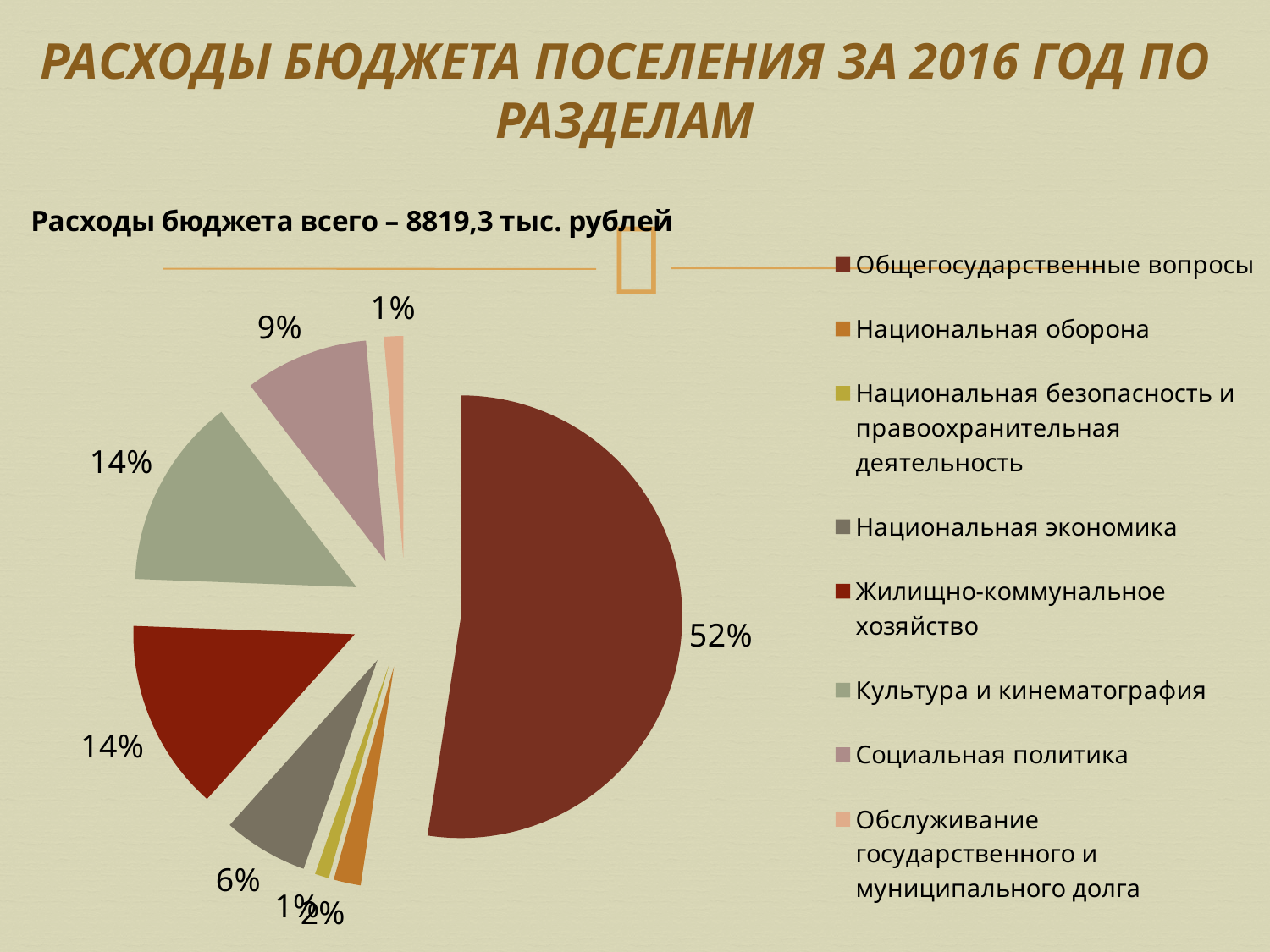
What share of the budget expenditure goes to Национальная экономика? 6% By how many percentage points does the share of Общегосударственные вопросы exceed the share of Социальная политика? 43 percentage points What share of the budget expenditure goes to Общегосударственные вопросы? 52% What kind of chart is shown on the slide? pie chart What share of the budget expenditure goes to Культура и кинематография? 14% Which section has the largest share of the budget expenditure? Общегосударственные вопросы How many sections (slices) does the pie chart show? 8 What share of the budget expenditure goes to Обслуживание государственного и муниципального долга? 1% What share of the budget expenditure goes to Жилищно-коммунальное хозяйство? 14% What share of the budget expenditure goes to Социальная политика? 9% What total budget expenditure is stated above the chart? 8819,3 тыс. рублей Which has the larger share: Социальная политика or Национальная экономика? Социальная политика